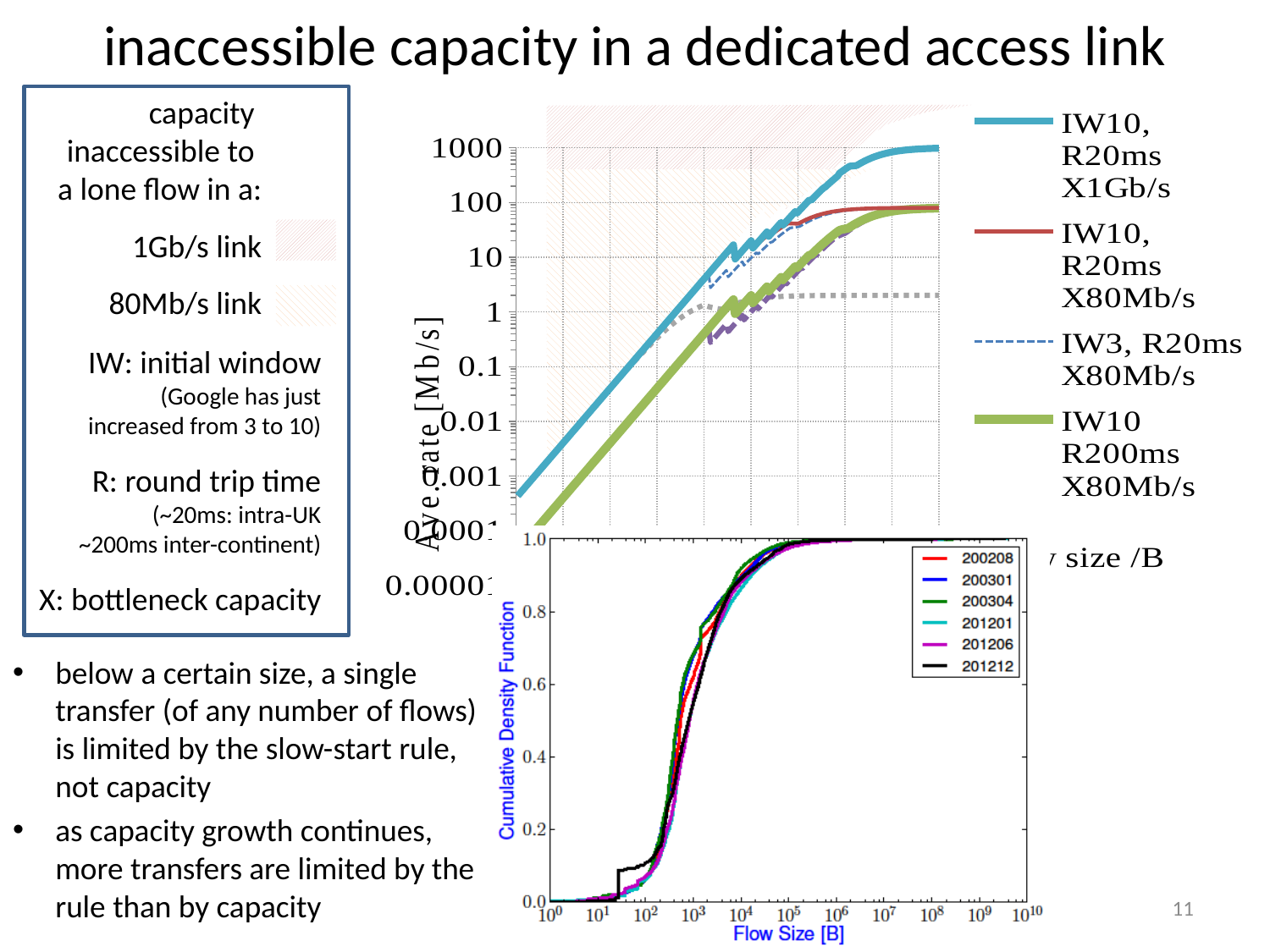
How many series does the legend of the top chart list? 4 How many series does the legend of the bottom chart list? 6 What kind of chart is the bottom chart (Cumulative Density Function vs Flow Size)? line chart What kind of chart is the top chart (Ave. rate vs flow size)? line chart In the top chart, is the plateau value of the IW10, R20ms, X80Mb/s line greater or less than 100 Mb/s? less In the top chart, which series reaches the highest average rate at large flow sizes? IW10, R20ms, X1Gb/s What is the x-axis label of the bottom chart? Flow Size [B] In the bottom chart, is the cumulative density at a flow size of 10^4 B greater or less than 0.8? greater In the bottom chart, is the cumulative density at a flow size of 10^2 B greater or less than 0.2? less In the top chart, at large flow sizes, which is higher: the IW10, R20ms, X1Gb/s line or the IW10, R200ms, X80Mb/s line? IW10, R20ms, X1Gb/s In the bottom chart, do the cumulative density curves rise or fall as flow size increases? rise